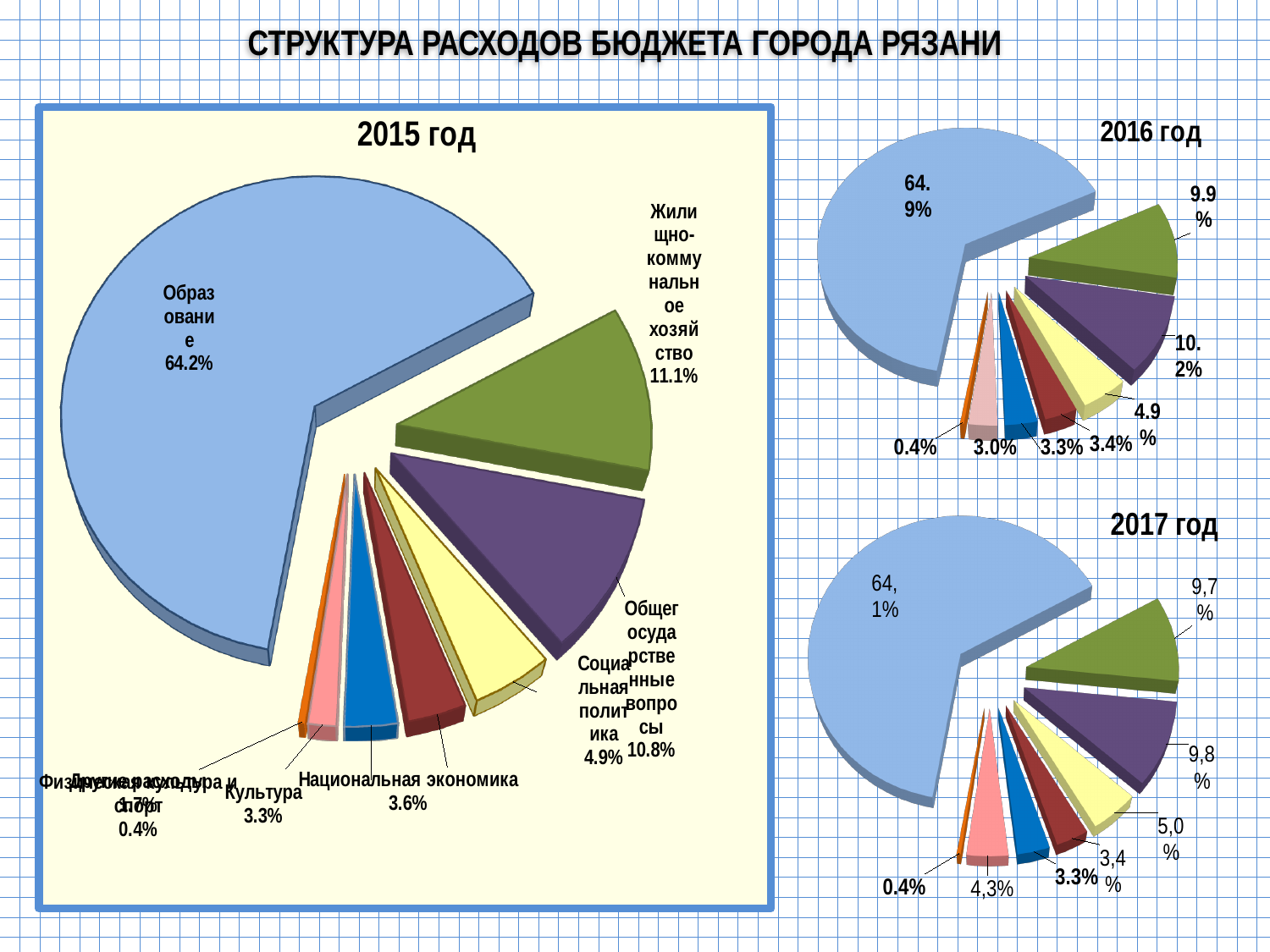
What is the title of the slide containing the three pie charts? СТРУКТУРА РАСХОДОВ БЮДЖЕТА ГОРОДА РЯЗАНИ In the 2015 год chart, which category has the largest share? Образование In the 2015 год chart, what is the value for Общегосударственные вопросы? 10.8% In the 2015 год chart, what is the difference between Жилищно-коммунальное хозяйство and Общегосударственные вопросы? 0.3% What kind of chart is used for the 2015 год chart? pie chart In the 2016 год chart, what is the value of the largest slice? 64.9% In the 2016 год chart, what is the value of the smallest slice? 0.4% In the 2015 год chart, which is larger: Социальная политика or Культура? Социальная политика In the 2015 год chart, what share of the budget goes to Образование? 64.2% In the 2015 год chart, what is the value for Жилищно-коммунальное хозяйство? 11.1% In the 2015 год chart, what is the value for Национальная экономика? 3.6% In the 2017 год chart, what is the value of the largest slice? 64,1%